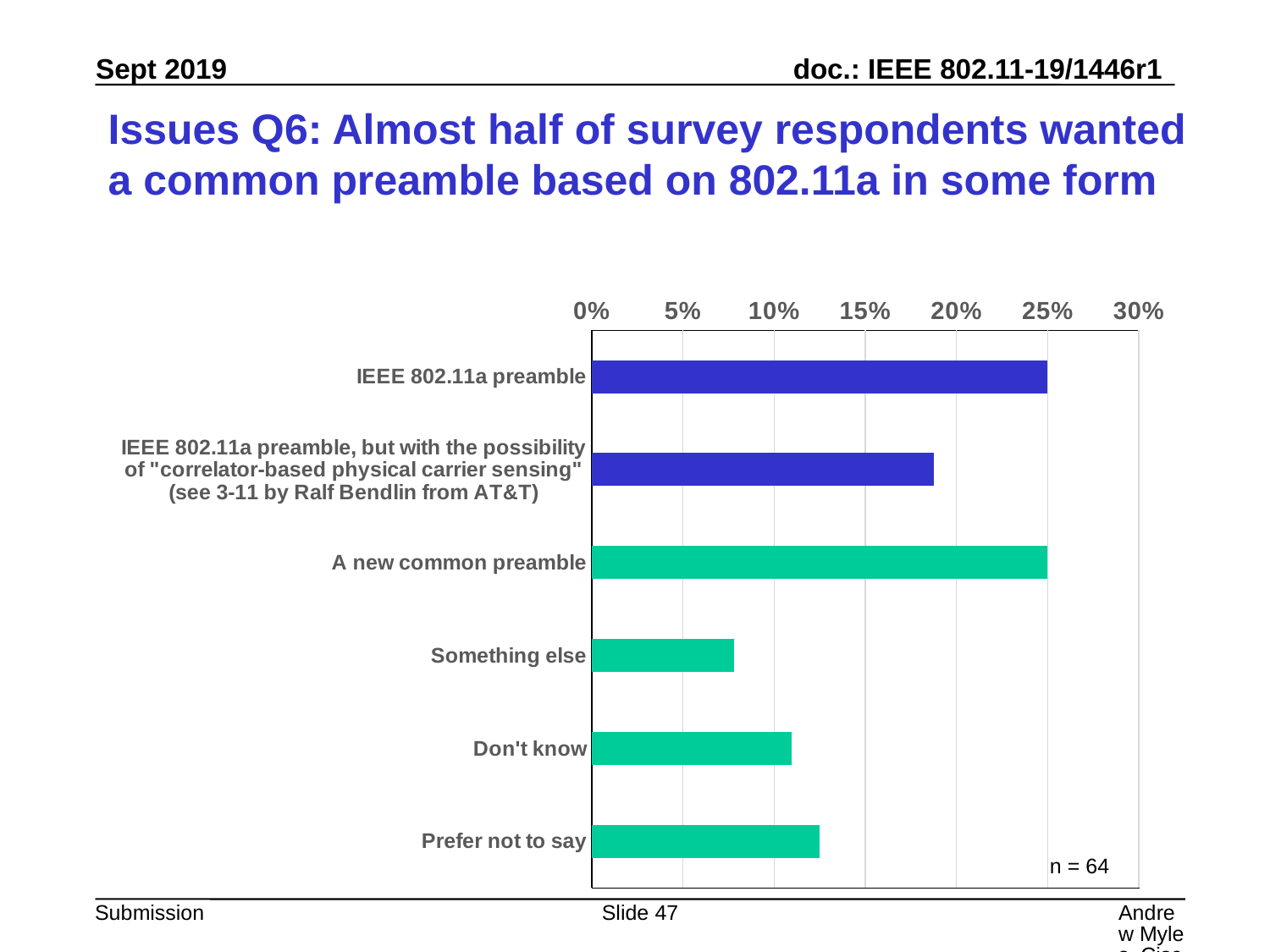
Is the value for "IEEE 802.11a preamble, but with the possibility of 'correlator-based physical carrier sensing'" greater or less than 15%? greater Which is larger, the value for "Something else" or the value for "Don't know"? Don't know How many bars in the chart are coloured blue rather than green? 2 What kind of chart is shown on the slide? bar chart Is the value for "Something else" greater or less than 10%? less Is the value for "Prefer not to say" greater or less than 15%? less Which category has the lowest value in the chart? Something else How many categories (bars) does the chart show? 6 What is the value for "IEEE 802.11a preamble"? 25% What sample size (n) is noted on the chart? n = 64